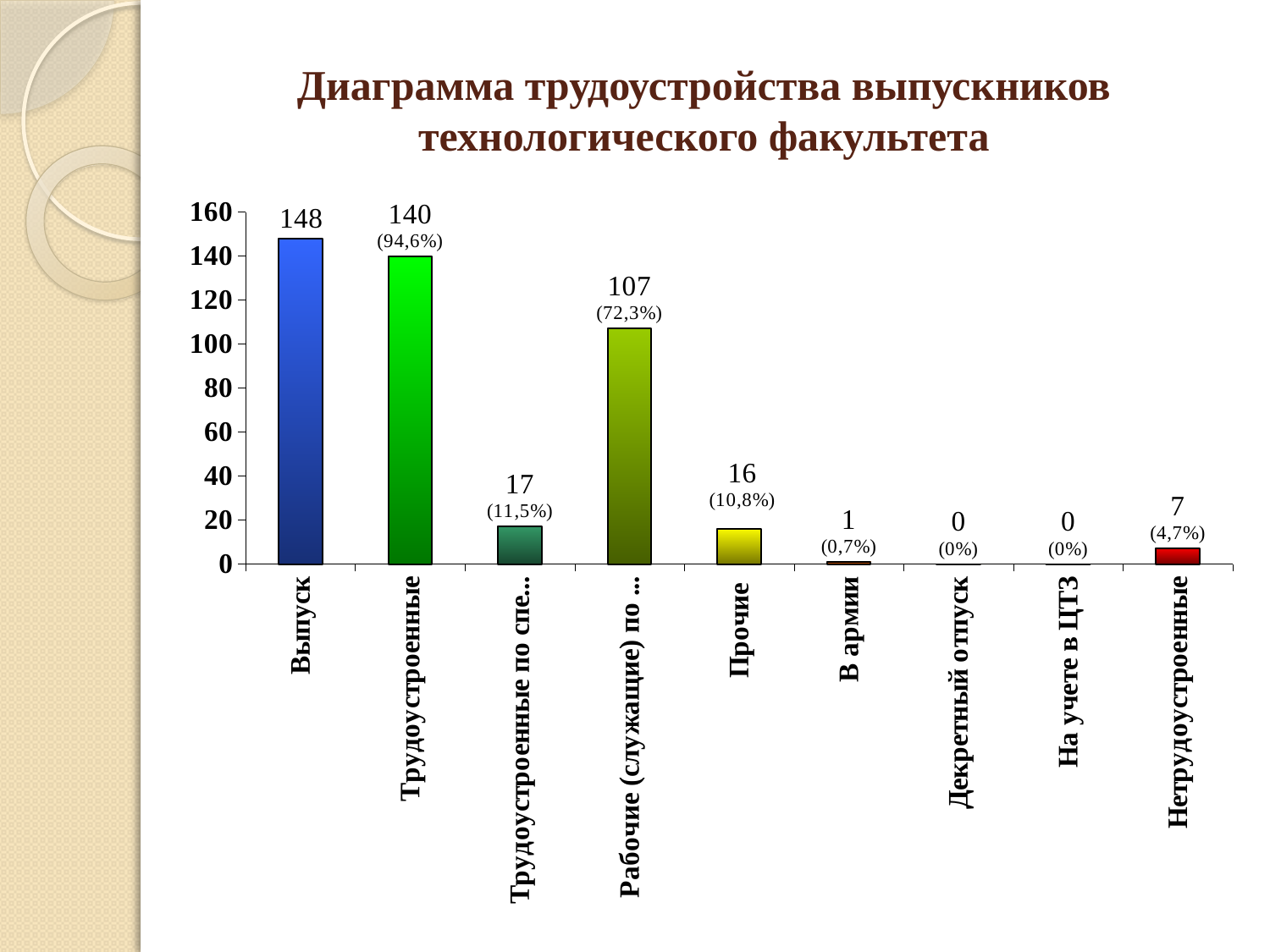
What type of chart is shown on the slide? bar chart Which is larger, the value for Прочие or the value for Нетрудоустроенные? Прочие What is the value for В армии? 1 What percentage is shown for Прочие? 10,8% What is the value for Выпуск? 148 Which category has the highest value? Выпуск What is the title of the chart? Диаграмма трудоустройства выпускников технологического факультета What is the difference between the values for Выпуск and Трудоустроенные? 8 What is the value for Трудоустроенные? 140 What is the value for Нетрудоустроенные? 7 How many categories are shown on the x axis? 9 What percentage is shown for На учете в ЦТЗ? 0%